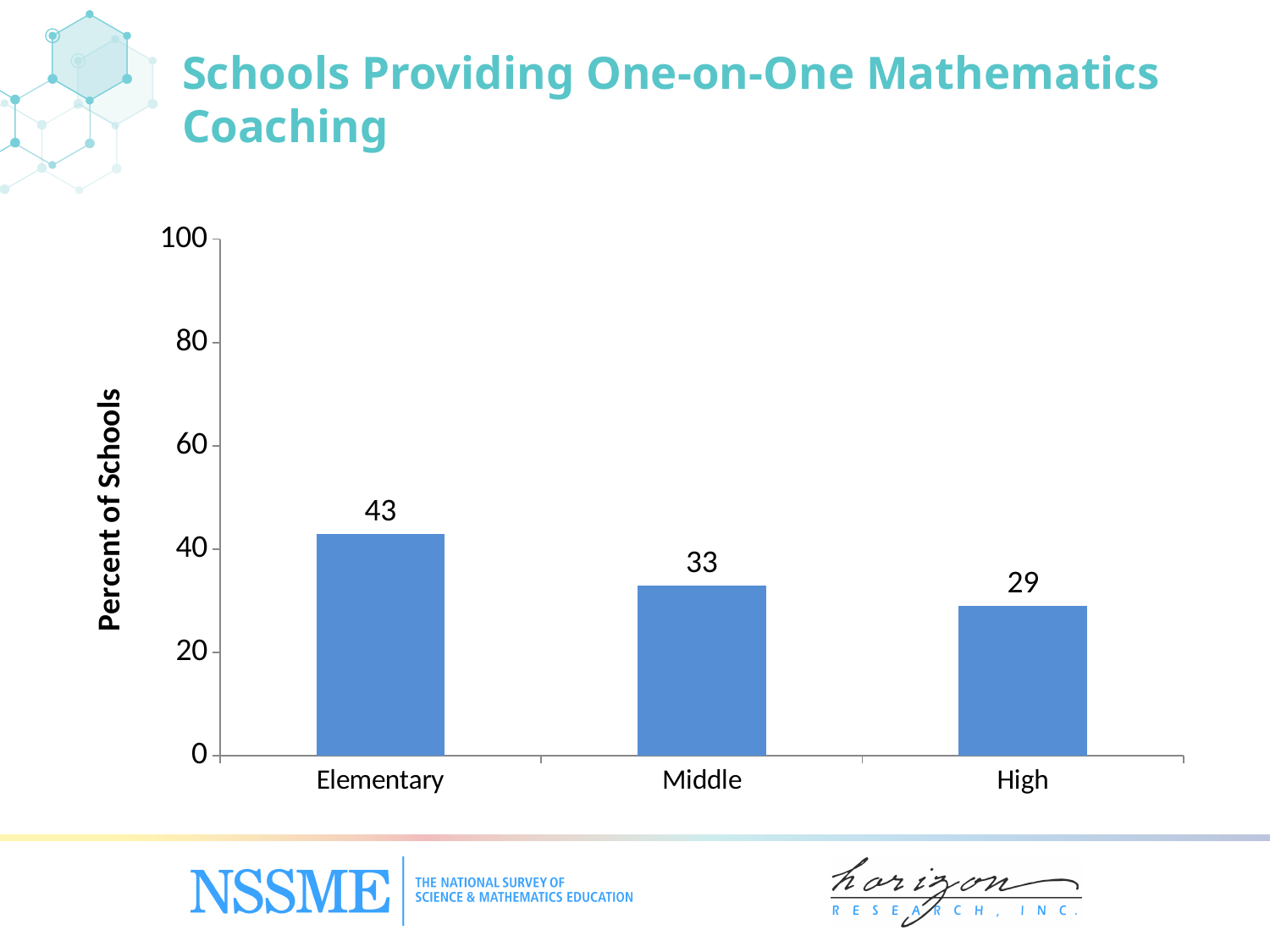
Do the values rise or fall from Elementary to High along the x axis? Fall Is the value for Elementary greater or less than 40? greater What kind of chart is shown on the slide? Bar chart What percent of elementary schools provide one-on-one mathematics coaching? 43 Which is larger, the value for Elementary or the value for Middle? Elementary How many school levels are shown on the x axis? 3 What is the difference between the values for Middle and High schools? 4 What is the difference between the values for Elementary and High schools? 14 Which school level has the highest percent of schools providing one-on-one mathematics coaching? Elementary What is the value for High schools? 29 Which school level has the lowest percent of schools providing one-on-one mathematics coaching? High What is the value for Middle schools? 33